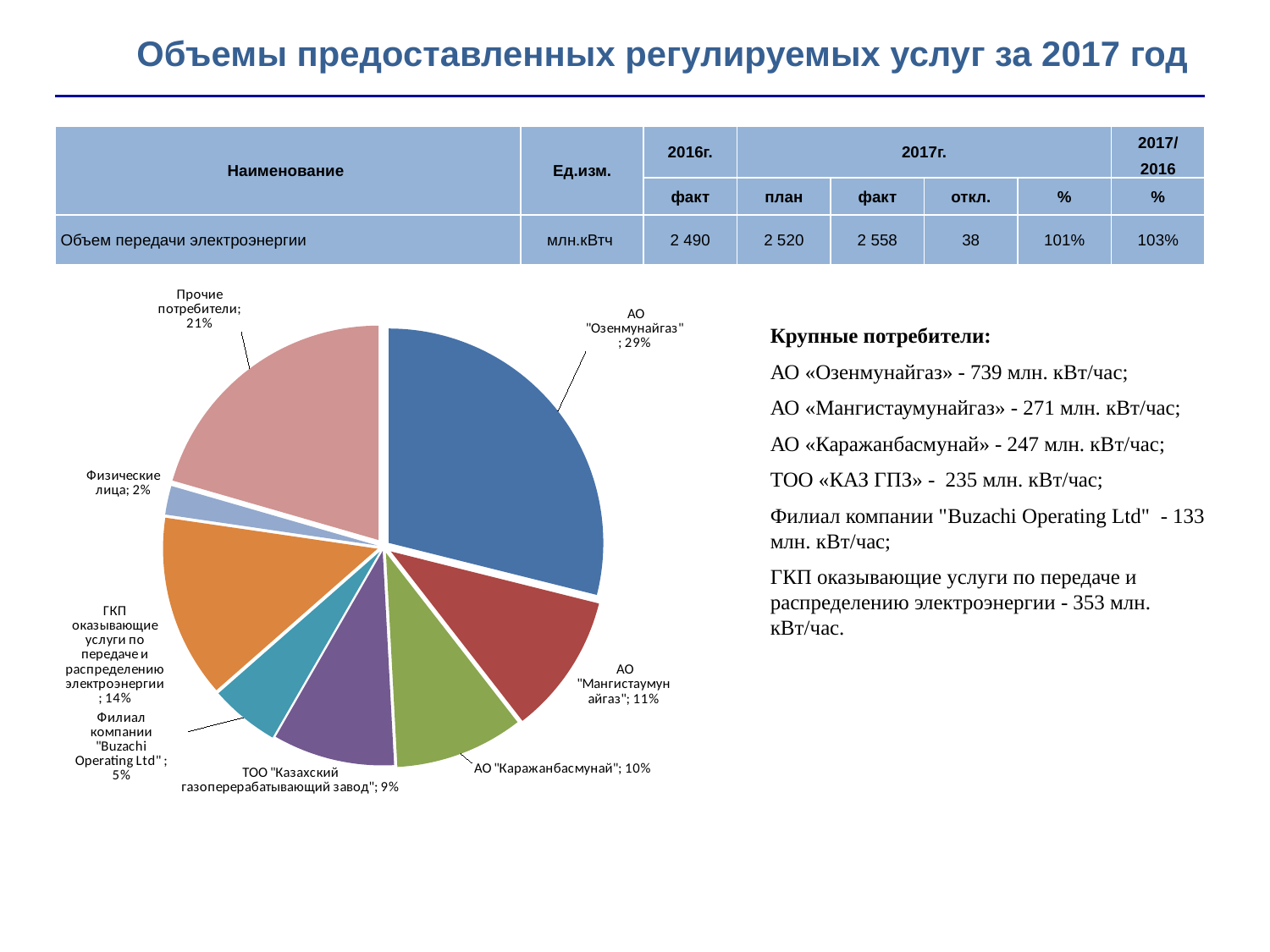
Which slice of the pie chart is the largest? АО "Озенмунайгаз" What share of the pie does АО "Озенмунайгаз" have? 29% What colour is the slice for АО "Озенмунайгаз"? blue What is the share for Филиал компании "Buzachi Operating Ltd"? 5% Which has a larger share: АО "Каражанбасмунай" or ТОО "Казахский газоперерабатывающий завод"? АО "Каражанбасмунай" What kind of chart is shown on the slide? pie chart What share of the pie does Физические лица have? 2% What share of the pie does Прочие потребители have? 21% Which slice of the pie chart is the smallest? Физические лица How many slices does the pie chart have? 8 What is the difference in percentage points between АО "Озенмунайгаз" and АО "Мангистаумунайгаз"? 18